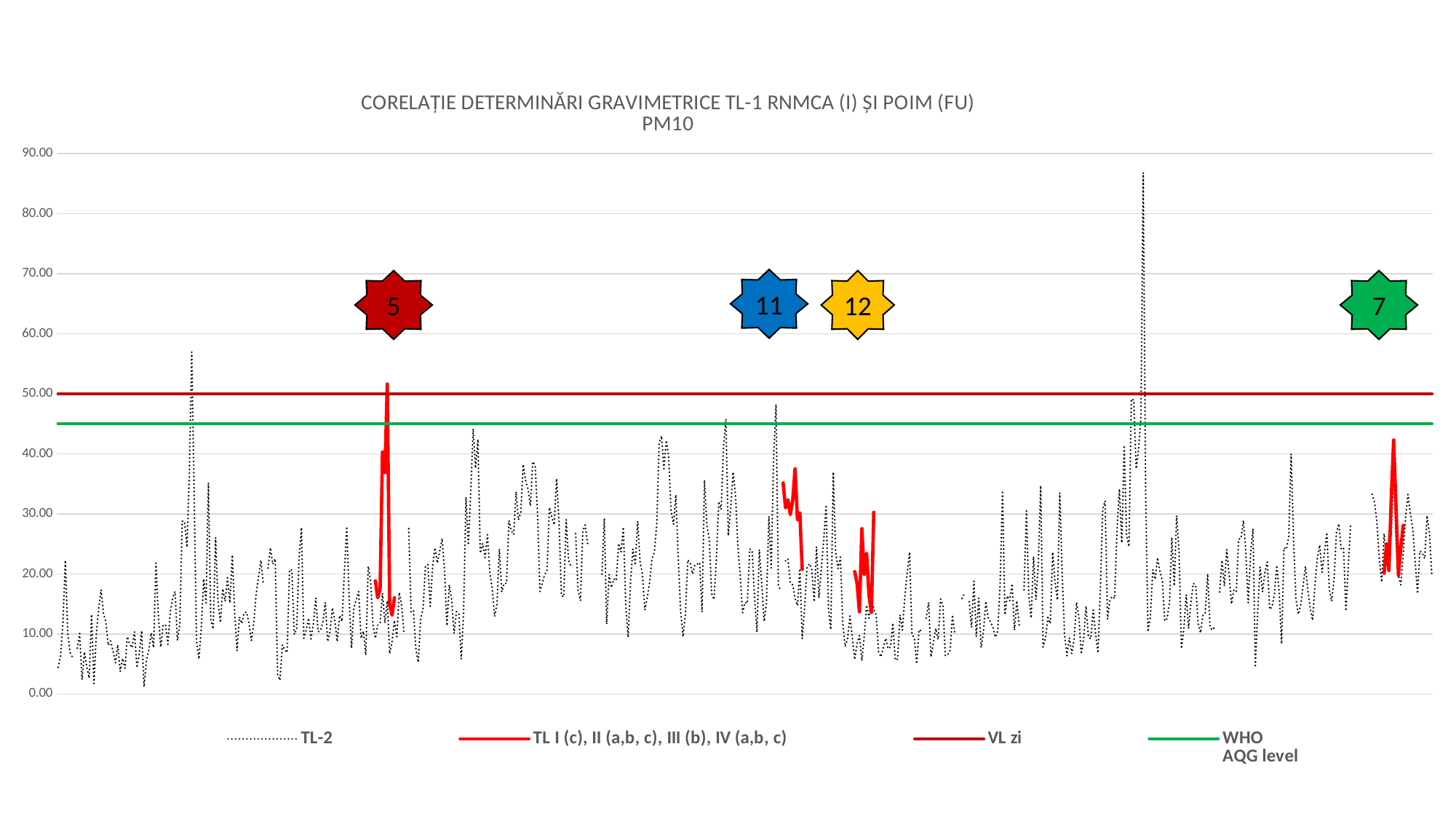
What is the value of the VL zi line? 50.00 Is the WHO AQG level line greater or less than 50.00? less Which is higher, the VL zi line or the WHO AQG level line? VL zi Which series is drawn as a dotted line? TL-2 What kind of chart is shown on the slide? line chart Is the highest value of the red TL I (c), II (a,b, c), III (b), IV (a,b, c) series greater or less than 60.00? less Is the WHO AQG level line greater or less than 40.00? greater What is the highest value shown on the vertical axis? 90.00 How many series does the legend list? 4 What colour is the WHO AQG level line? green